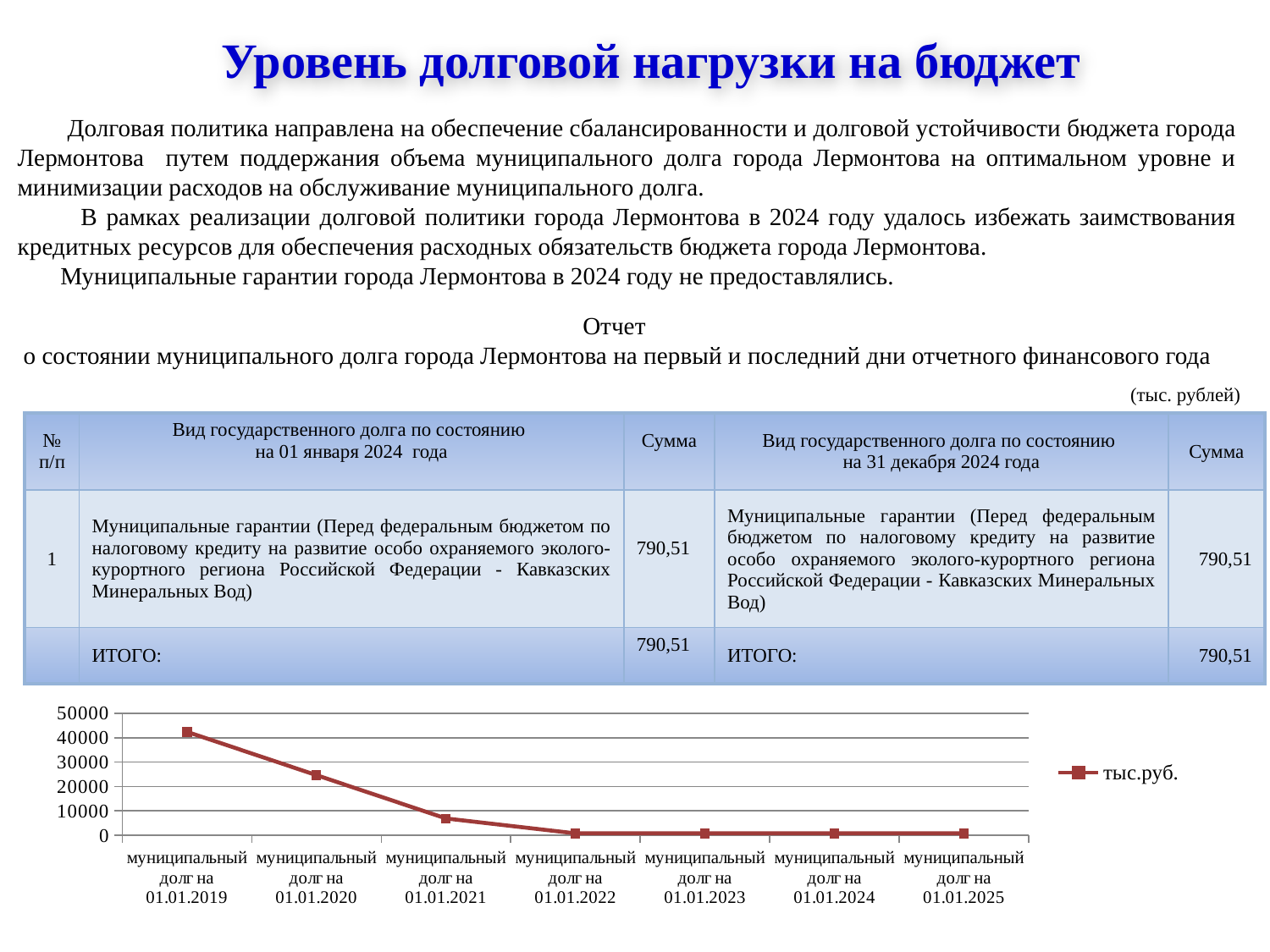
What is the legend entry of the line chart? тыс.руб. Is the value for муниципальный долг на 01.01.2020 greater or less than 20000? greater Which category has the highest value on the line chart? муниципальный долг на 01.01.2019 How many data points are plotted on the line chart? 7 Is the value for муниципальный долг на 01.01.2020 greater or less than 30000? less What kind of chart is shown at the bottom of the slide? line chart How many series does the legend of the line chart list? 1 Which is larger on the line chart: the value for 01.01.2019 or the value for 01.01.2020? 01.01.2019 What is the highest value shown on the y axis of the line chart? 50000 Is the value for муниципальный долг на 01.01.2021 greater or less than 10000? less Do the values on the line chart rise or fall from 01.01.2019 to 01.01.2025? fall